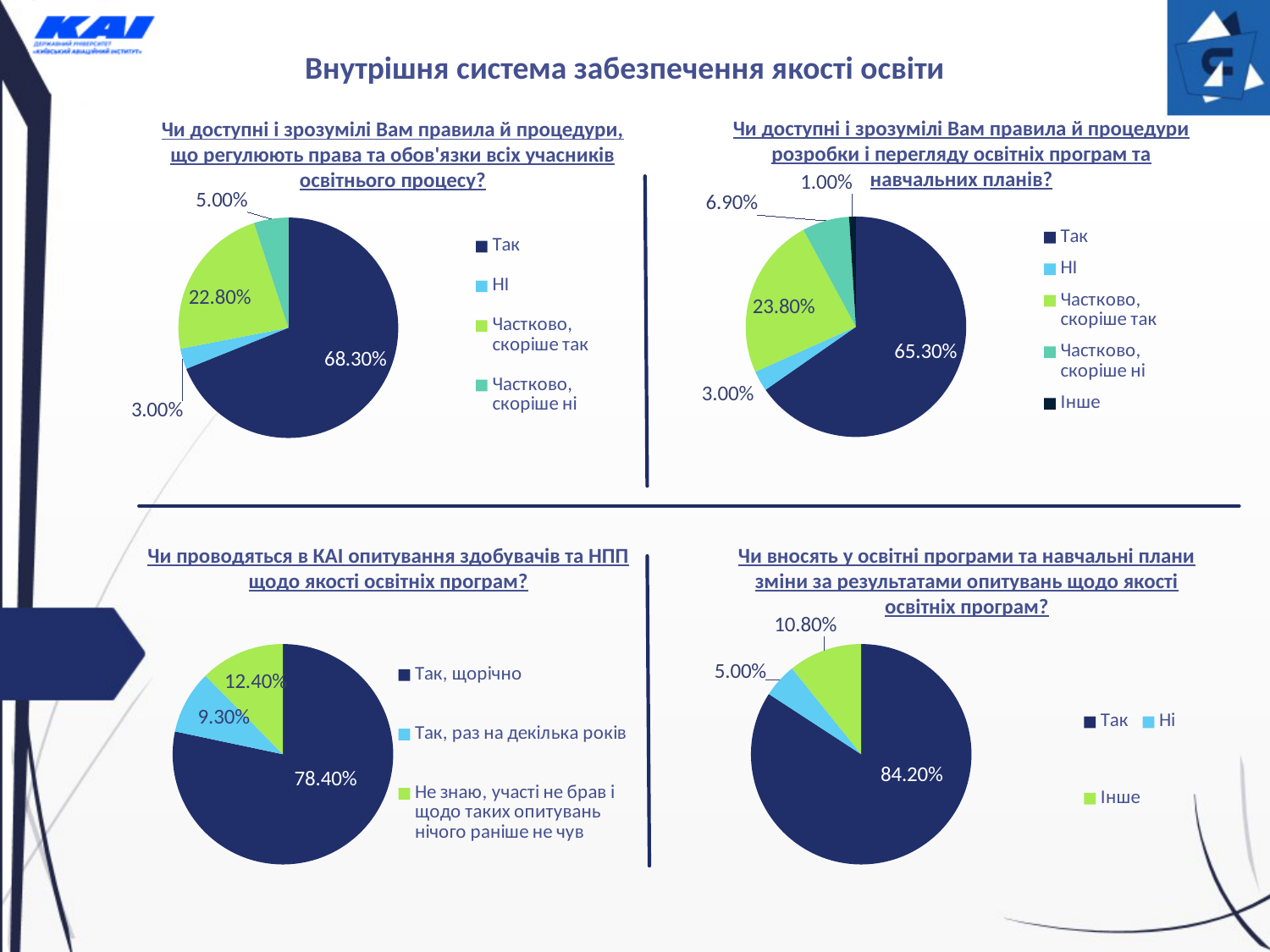
In the bottom-right pie chart, how many categories are shown? 3 In the bottom-left pie chart, which is larger: "Так, раз на декілька років" or "Не знаю, участі не брав і щодо таких опитувань нічого раніше не чув"? Не знаю, участі не брав і щодо таких опитувань нічого раніше не чув In the top-left pie chart, what is the value for "Частково, скоріше так"? 22.80% In the bottom-left pie chart, what percentage answered "Так, щорічно"? 78.40% In the top-right pie chart, what is the value for "Частково, скоріше ні"? 6.90% In the top-right pie chart, what is the value for "Інше"? 1.00% What type of chart is used for all four charts on the slide? Pie chart In the top-right pie chart, what is the difference between the "Так" share and the "Частково, скоріше так" share? 41.50% In the bottom-right pie chart, what is the value for "Інше"? 10.80% In the top-left pie chart, which category has the smallest share? НІ In the top-right pie chart, how many entries does the legend list? 5 In the top-left pie chart, what percentage of respondents answered "Так"? 68.30%